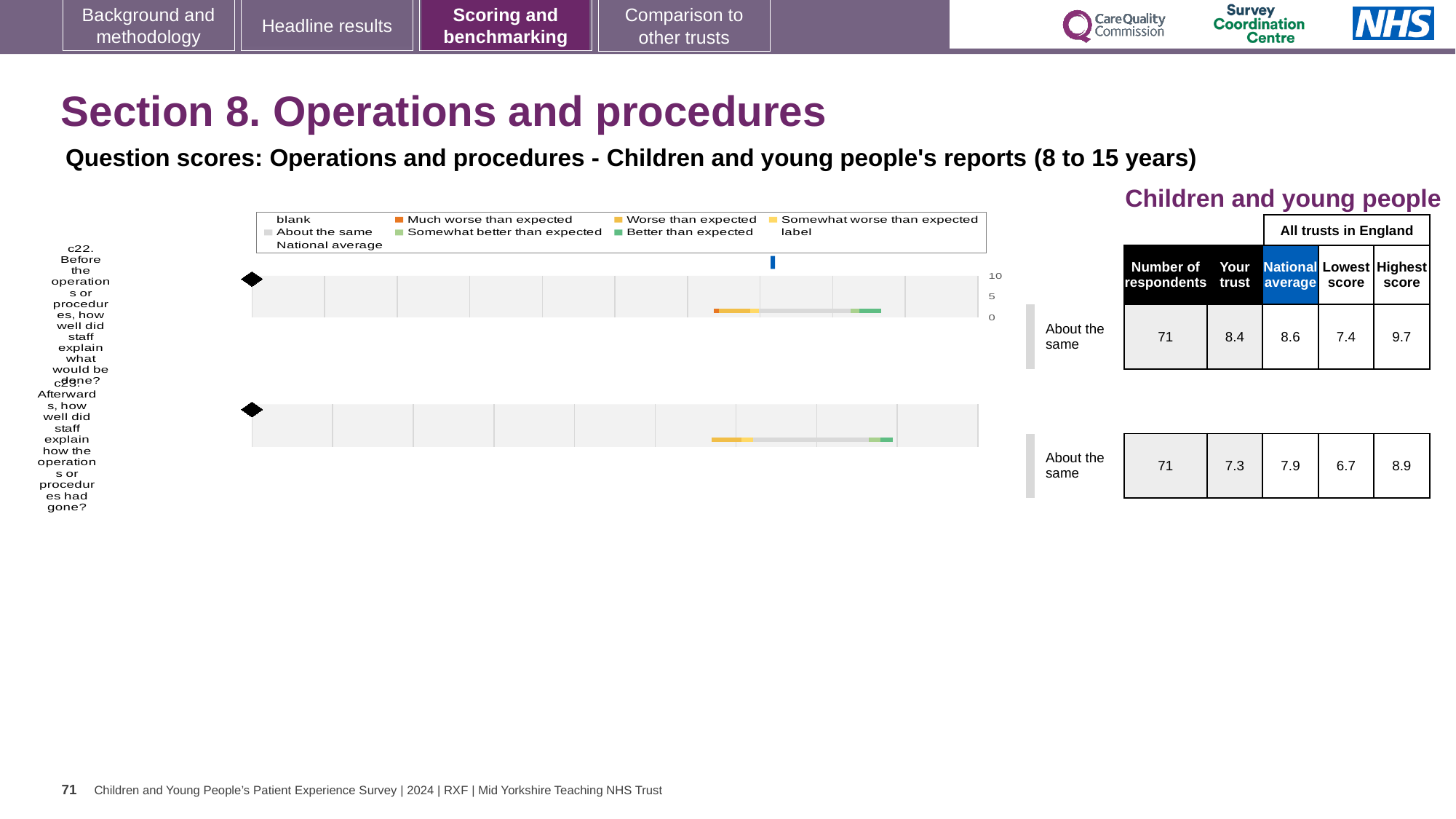
What benchmark category is shown next to the c22 chart? About the same What colour does the legend use for 'Much worse than expected'? orange For the c22 chart (Before the operations or procedures, how well did staff explain what would be done?), what is the 'Your trust' score? 8.4 What kind of chart is used to show the question scores for c22 and c23 on this slide? bar chart How many respondents are shown for the c23 chart? 71 Which question has the higher 'Your trust' score, c22 or c23? c22 How many question charts (c22 and c23) are plotted on this slide? 2 For the c22 chart, what is the difference between the highest score (9.7) and the lowest score (7.4) across all trusts in England? 2.3 For the c23 chart, how much higher is the national average (7.9) than the 'Your trust' score (7.3)? 0.6 For the c22 chart, what is the national average score? 8.6 For the c23 chart (Afterwards, how well did staff explain how the operations or procedures had gone?), what is the 'Your trust' score? 7.3